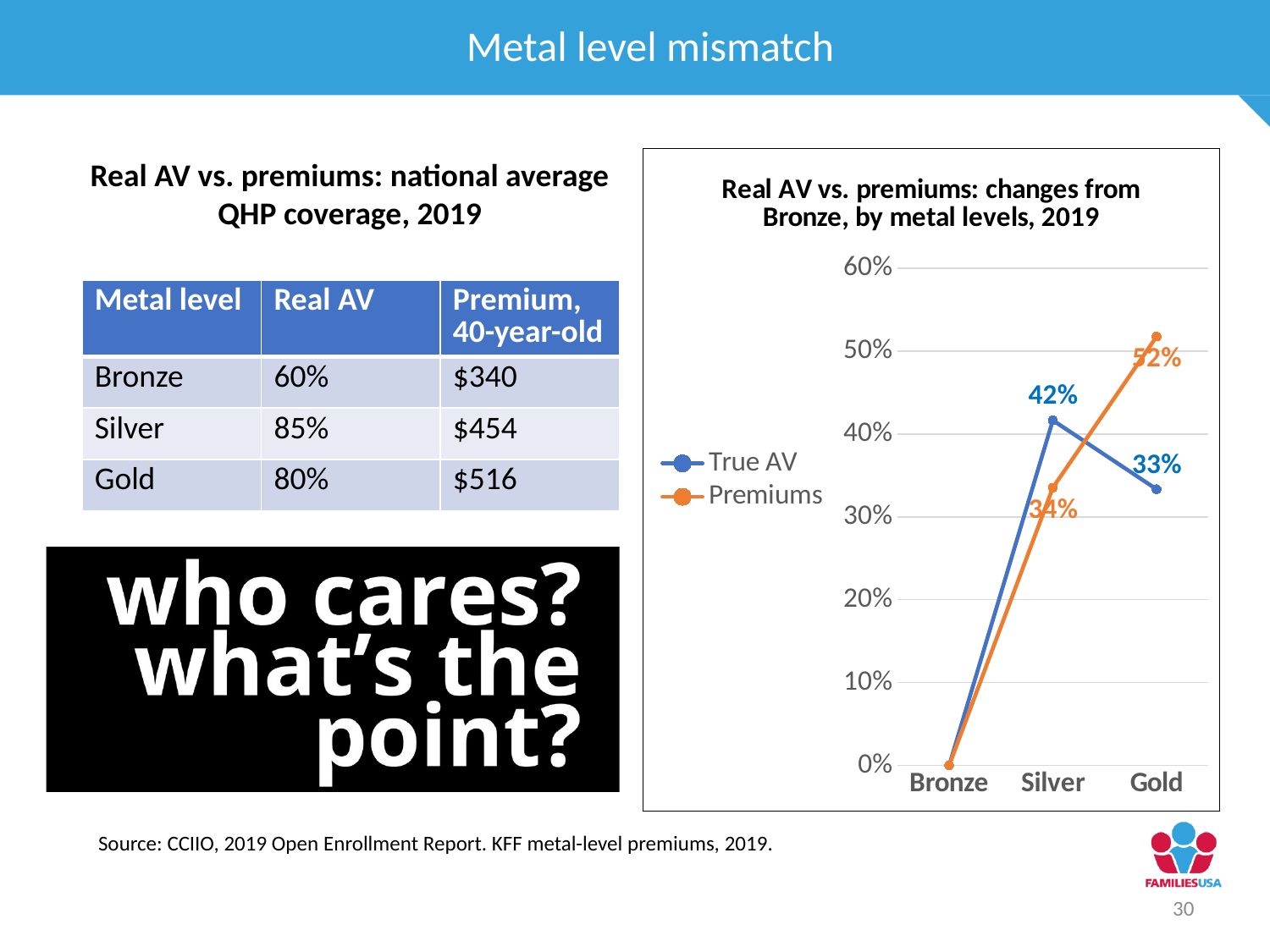
What is the True AV value for Gold in the chart? 33% At Silver, which series has the larger value, True AV or Premiums? True AV What is the difference between the True AV values for Silver and Gold? 9 percentage points What is the True AV value for Silver in the chart? 42% How many series does the chart's legend list? 2 At Gold, which series has the larger value, True AV or Premiums? Premiums Which metal level has the highest True AV value in the chart? Silver How many metal-level categories are plotted on the x axis of the chart? 3 What is the True AV value for Bronze in the chart? 0% What is the Premiums value for Gold in the chart? 52% What kind of chart is shown on the slide? line chart Is the Premiums value for Silver greater or less than 30%? greater